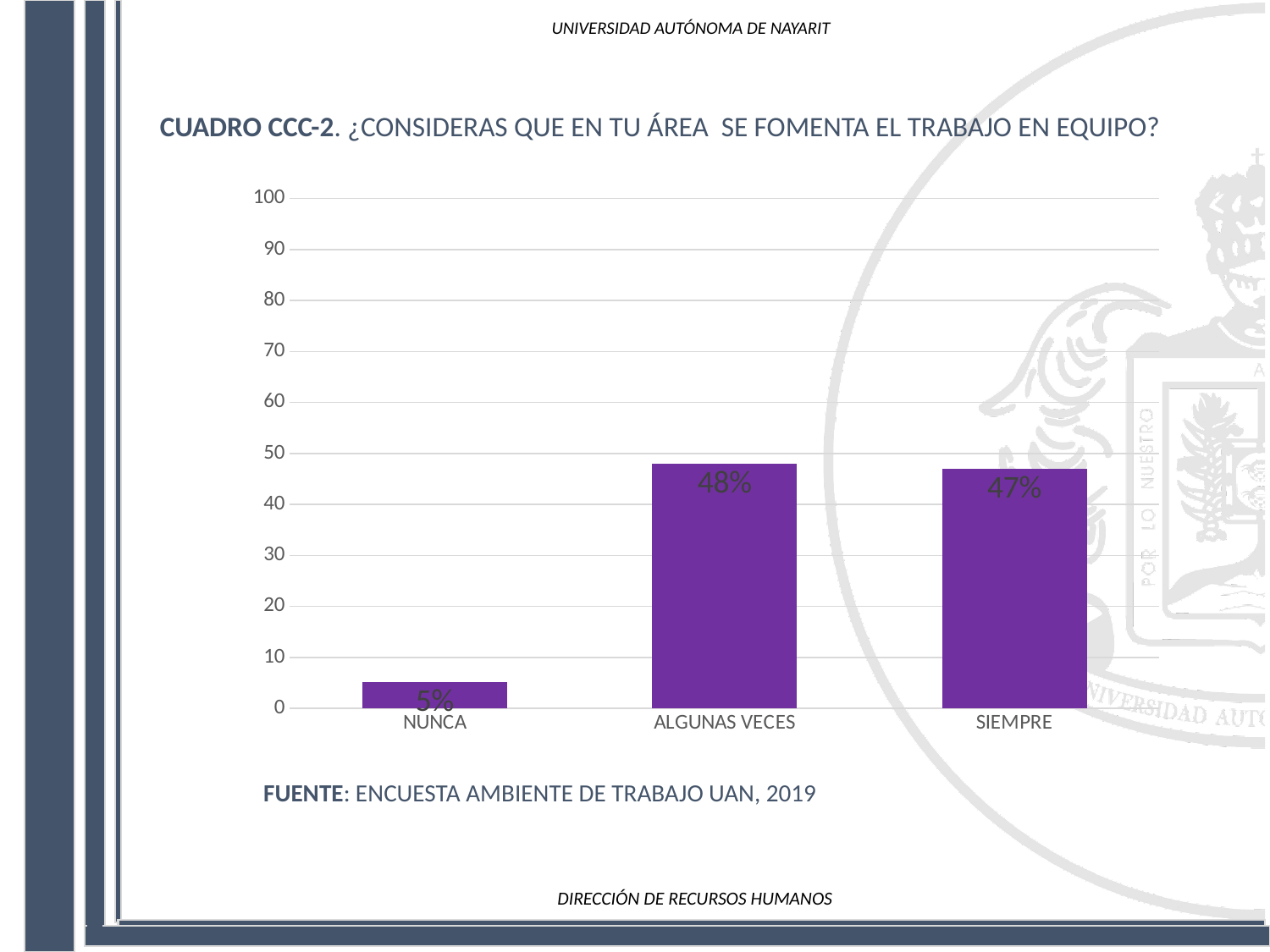
What is the value for ALGUNAS VECES? 48% Is the value for NUNCA greater or less than 10? less How many categories are shown on the x axis? 3 Which is larger, the value for SIEMPRE or the value for NUNCA? SIEMPRE What is the difference between the values for ALGUNAS VECES and NUNCA? 43% Which category has the lowest value? NUNCA What kind of chart is shown on the slide? bar chart What is the value for NUNCA? 5% Which category has the highest value? ALGUNAS VECES What is the difference between the values for ALGUNAS VECES and SIEMPRE? 1% What is the value for SIEMPRE? 47% Is the value for ALGUNAS VECES greater or less than 50? less